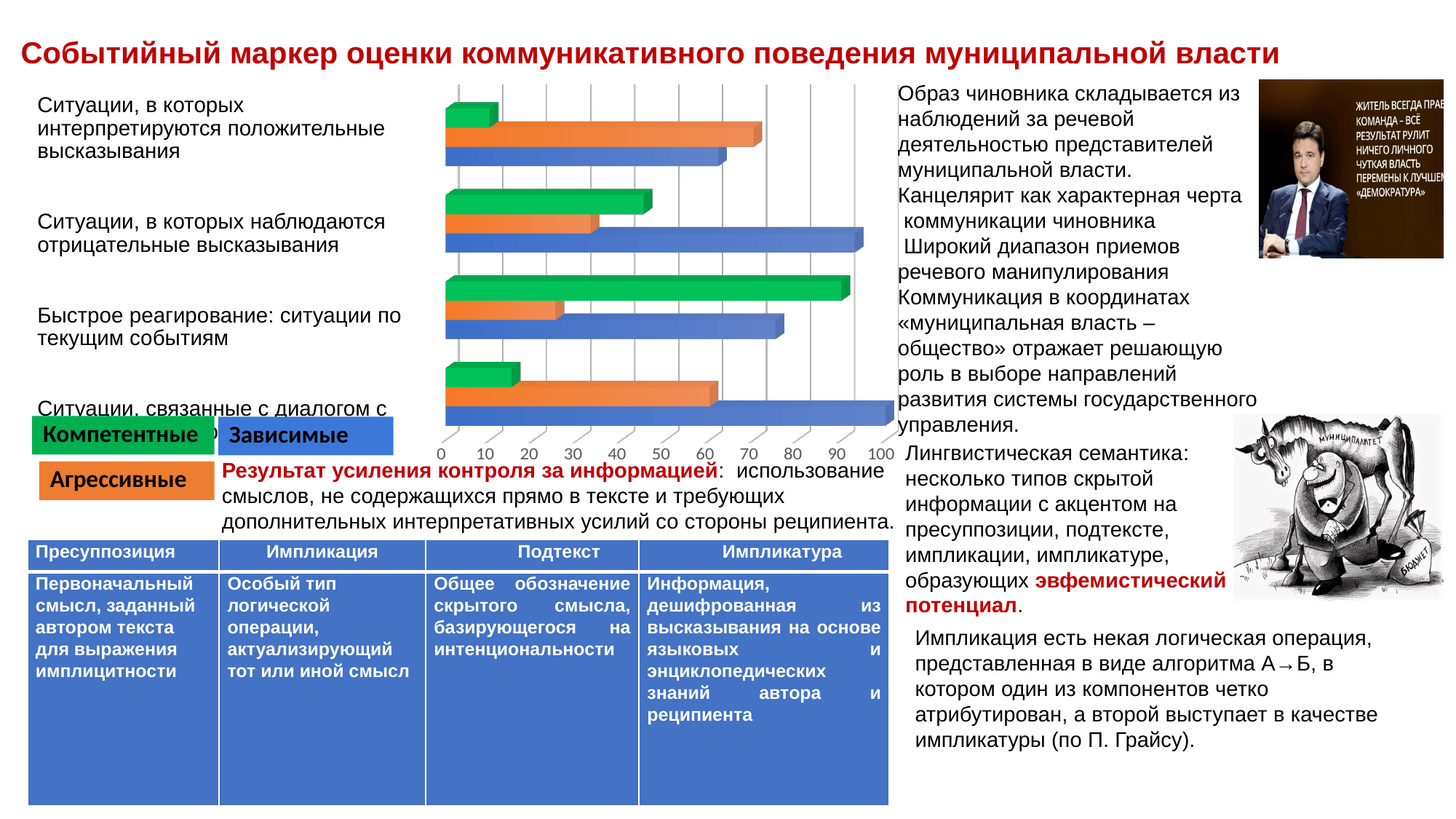
Is the Компетентные value for 'Быстрое реагирование: ситуации по текущим событиям' greater or less than 80? greater Which category has the highest Компетентные value? Быстрое реагирование: ситуации по текущим событиям Which series is shown in green in the chart? Компетентные Which series is shown in orange in the chart? Агрессивные For 'Ситуации, в которых наблюдаются отрицательные высказывания', which is larger: the Зависимые value or the Агрессивные value? Зависимые How many series does the chart's legend list? 3 Is the Агрессивные value for 'Быстрое реагирование: ситуации по текущим событиям' greater or less than 40? less Is the Зависимые value for 'Ситуации, в которых наблюдаются отрицательные высказывания' greater or less than 80? greater How many categories are plotted on the chart? 4 For 'Ситуации, в которых интерпретируются положительные высказывания', which is larger: the Агрессивные value or the Компетентные value? Агрессивные What kind of chart is shown on the slide? bar chart